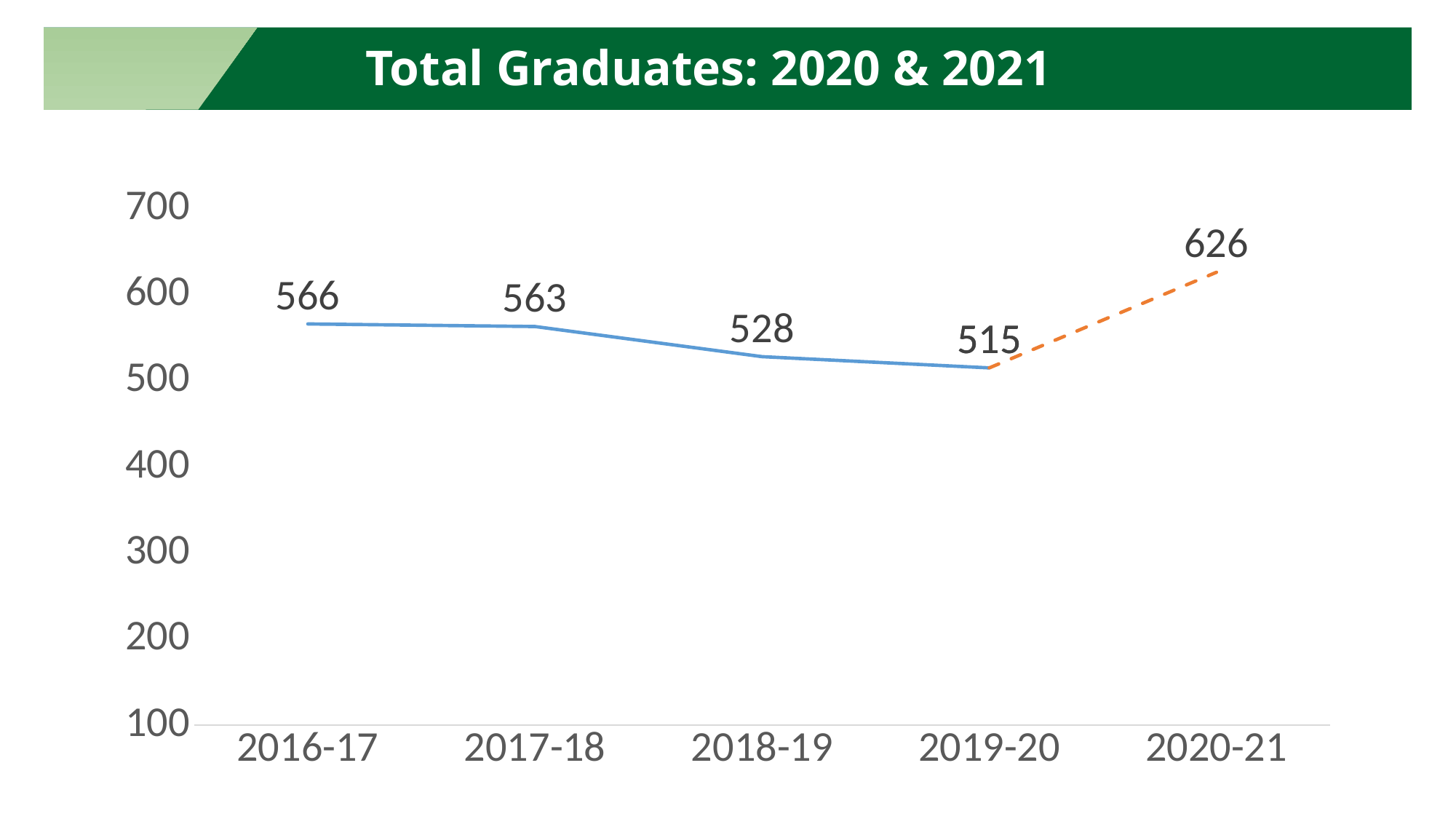
Is the value for 2020-21 greater or less than 600? greater How many years are plotted on the x axis? 5 What kind of chart is shown on the slide? line chart Which is larger, the value for 2017-18 or the value for 2019-20? 2017-18 Which year has the highest value? 2020-21 What is the value for 2018-19? 528 What is the value for 2016-17? 566 What is the difference between the values for 2020-21 and 2019-20? 111 What is the title of the chart? Total Graduates: 2020 & 2021 What is the value for 2020-21? 626 What is the difference between the values for 2016-17 and 2018-19? 38 Which year has the lowest value? 2019-20